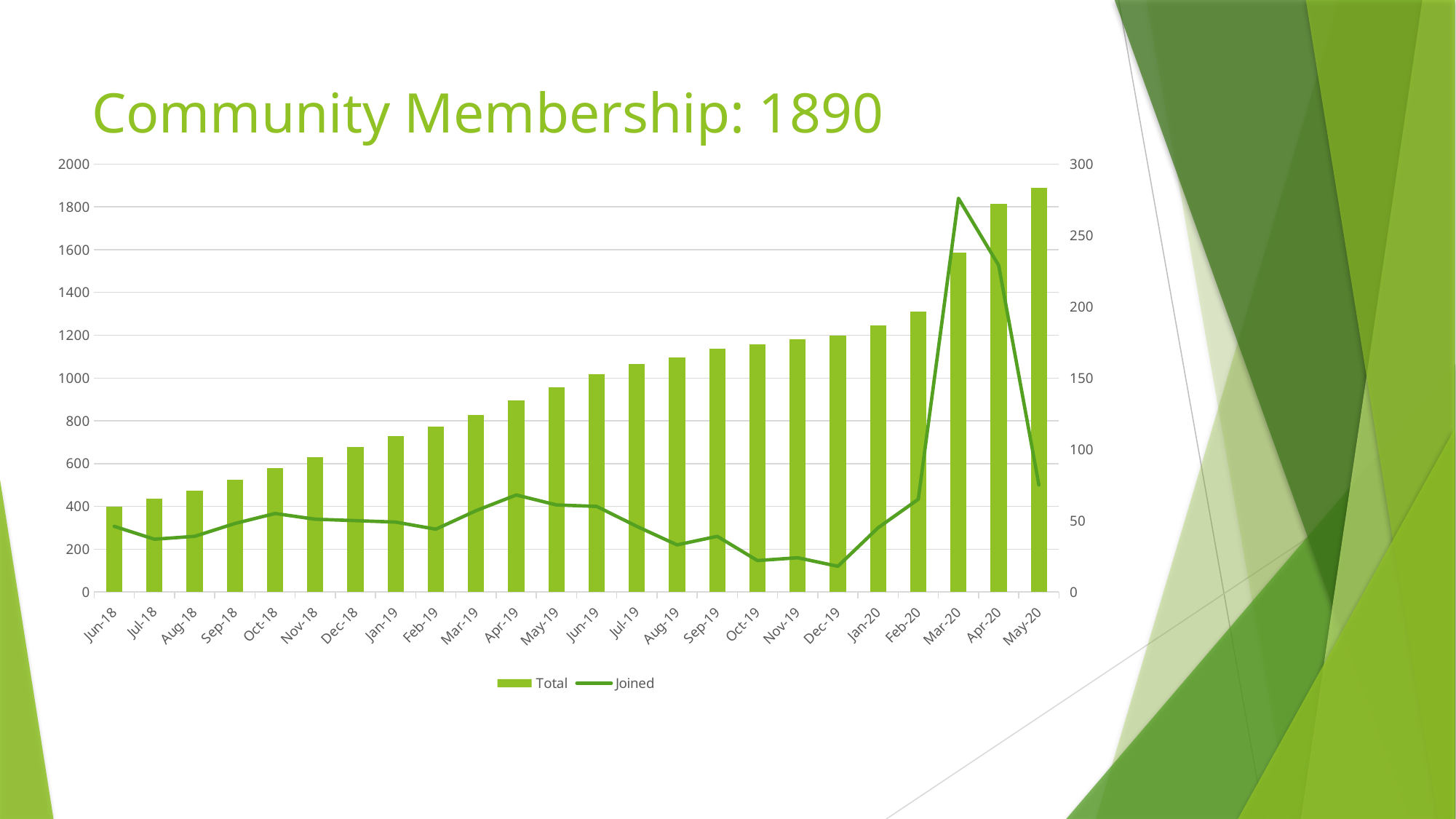
Which is larger, the Total for Apr-20 or the Total for Mar-20? Apr-20 Which month has the highest Total bar? May-20 Do the Total bars rise or fall from Jun-18 to May-20? rise Is the Joined value for Dec-19 greater or less than 50? less What kind of chart is shown on the slide? A combination bar and line chart How many months are shown on the x axis? 24 What is the title of the chart slide? Community Membership: 1890 Is the Joined value for Mar-20 greater or less than 250? greater Which month has the lowest Total bar? Jun-18 How many series does the legend list? 2 In which month does the Joined line reach its peak? Mar-20 Is the Total value for Mar-20 greater or less than 1400? greater